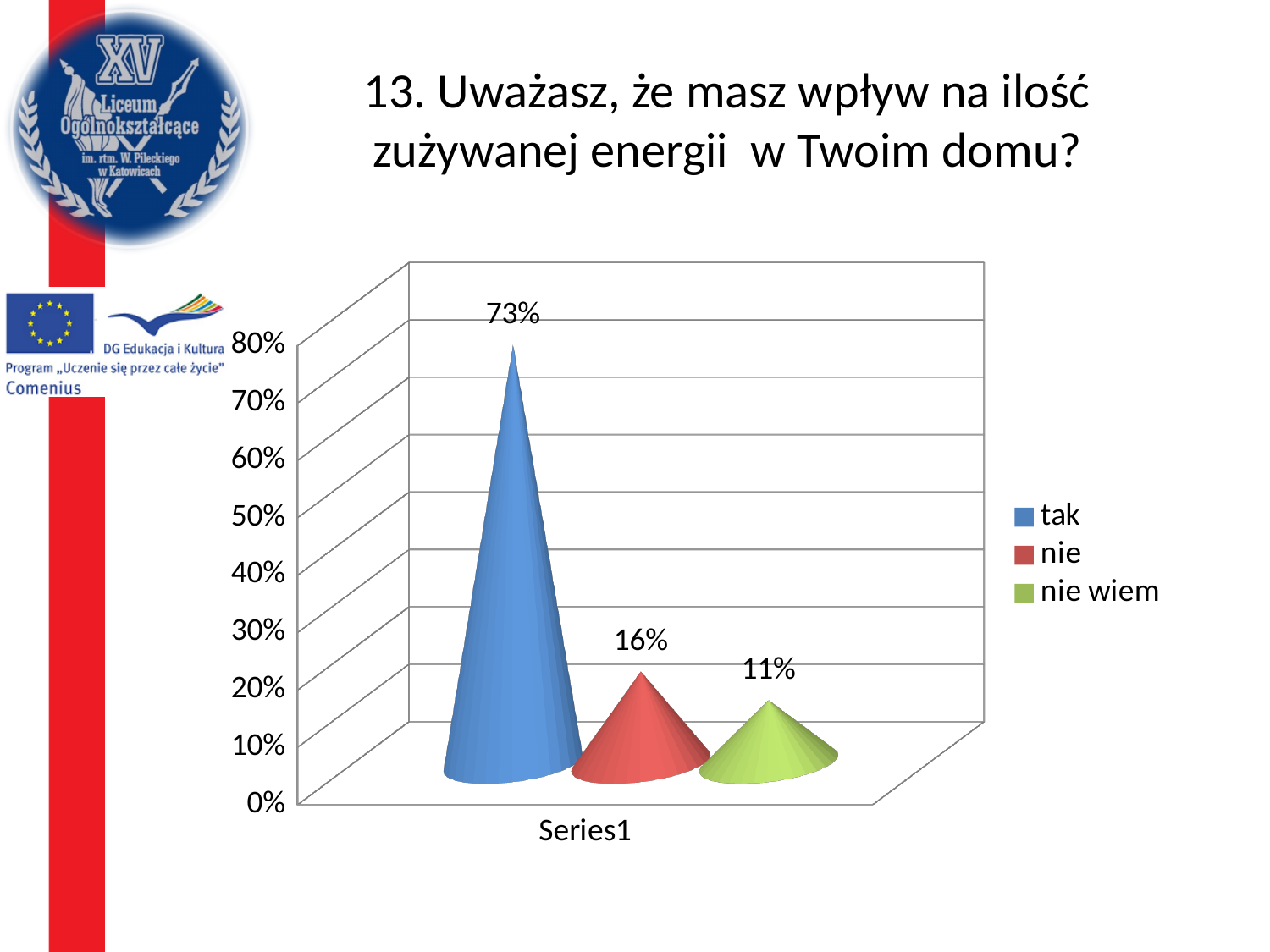
What colour represents "nie wiem" in the legend? green What is the value for "nie wiem"? 11% Which is larger, the value for "nie" or the value for "nie wiem"? nie Which answer has the lowest value? nie wiem Is the value for "tak" greater or less than 50%? greater What kind of chart is shown on the slide? bar chart Which answer has the highest value? tak How many series does the legend list? 3 What is the difference between the values for "nie" and "nie wiem"? 5% What is the value for "nie"? 16% What is the value for "tak"? 73% What is the difference between the values for "tak" and "nie"? 57%